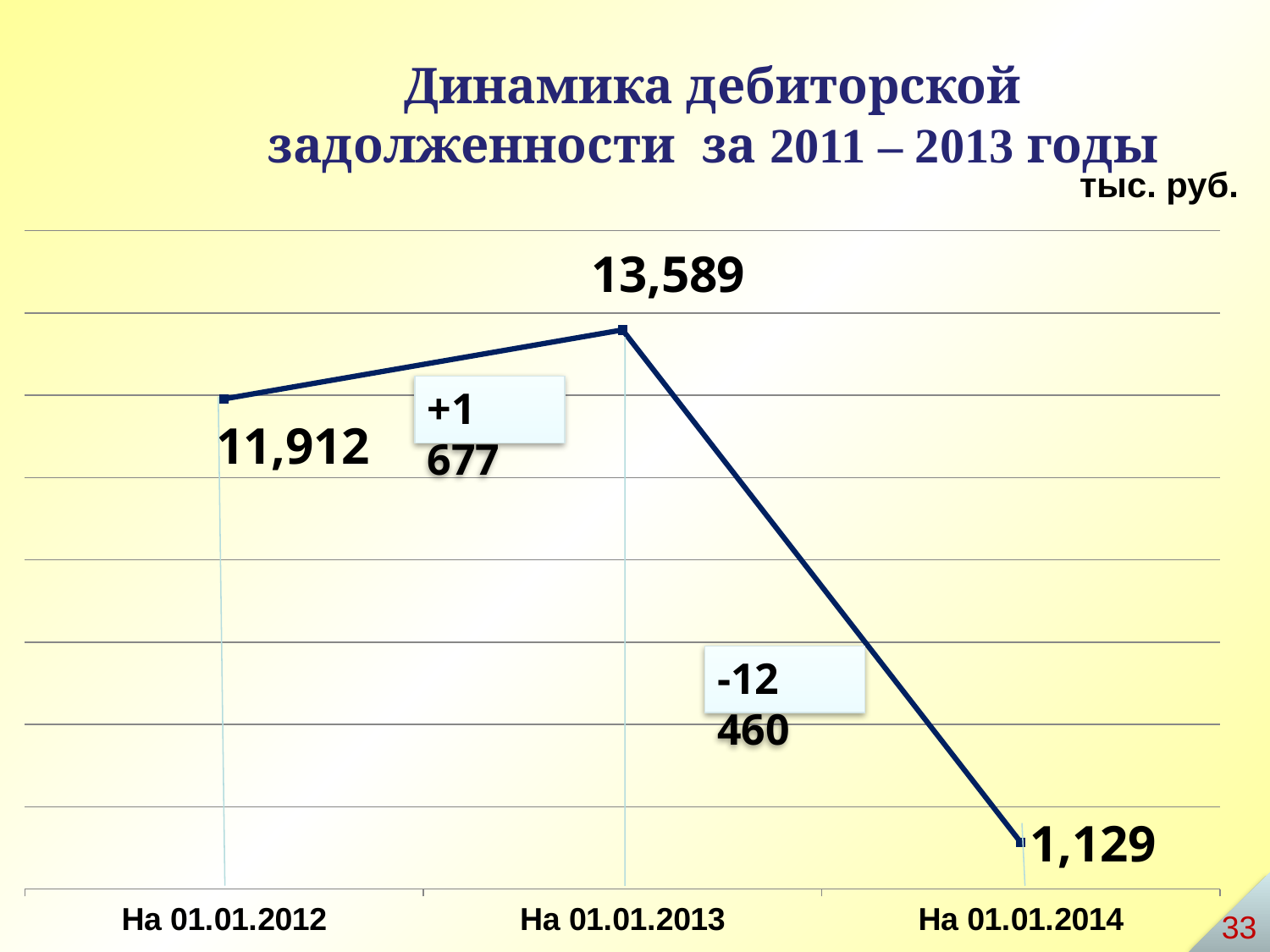
What unit of measurement is indicated on the chart? тыс. руб. Does the value rise or fall from На 01.01.2013 to На 01.01.2014? fall Which date has the lowest value? На 01.01.2014 What is the value for На 01.01.2012? 11,912 Which date has the highest value? На 01.01.2013 What is the value for На 01.01.2013? 13,589 What is the difference between the values for На 01.01.2013 and На 01.01.2012? 1,677 What kind of chart is shown on the slide? line chart What is the value for На 01.01.2014? 1,129 How many data points are plotted on the chart? 3 What is the difference between the values for На 01.01.2013 and На 01.01.2014? 12,460 Which is larger, the value for На 01.01.2012 or the value for На 01.01.2014? На 01.01.2012